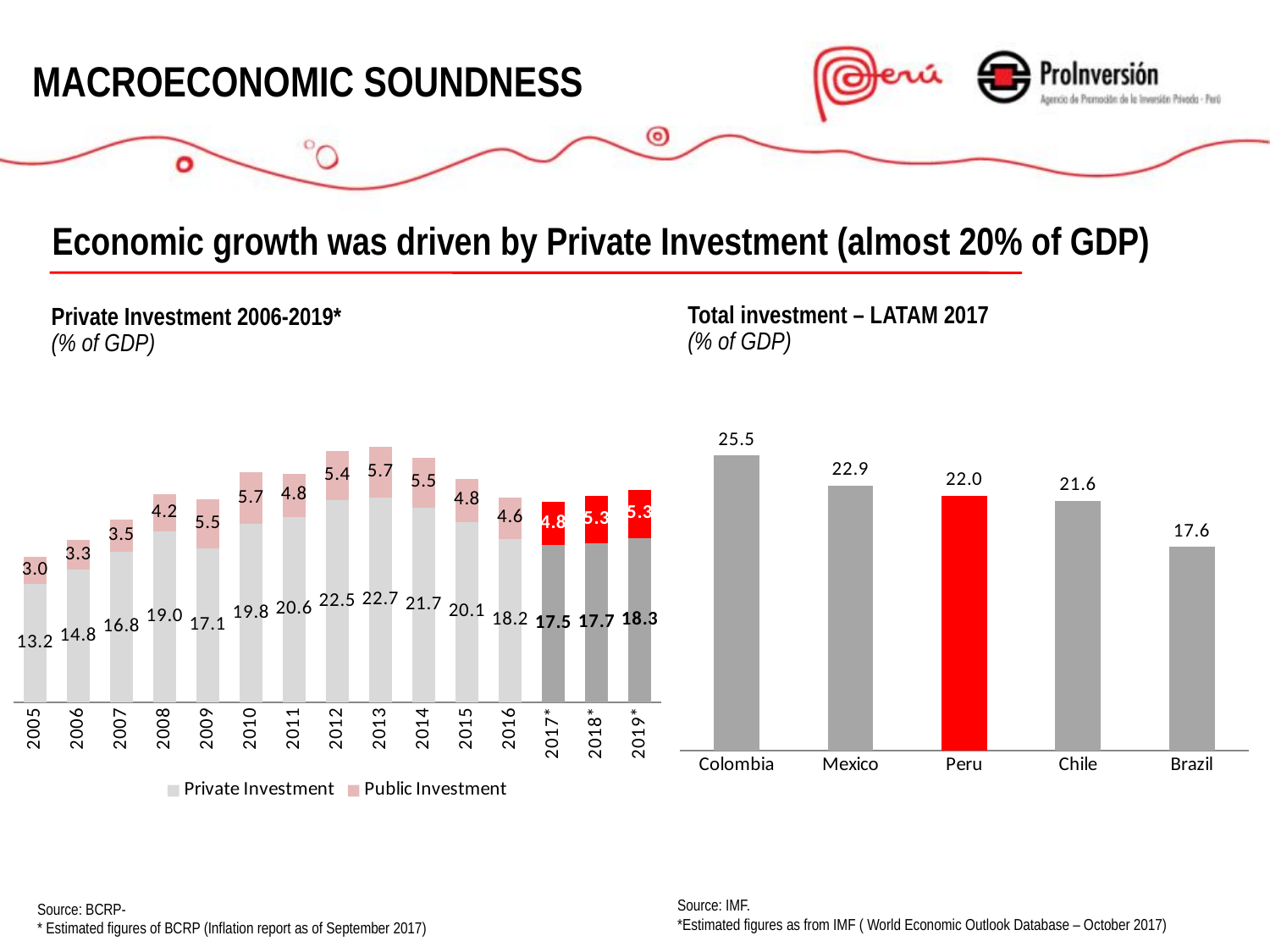
In the 'Total investment – LATAM 2017' chart, which bar is coloured red? Peru In the 'Private Investment 2006-2019*' chart, is Private Investment in 2012 larger or smaller than in 2016? larger In the 'Private Investment 2006-2019*' chart, how many series does the legend list? 2 In the 'Private Investment 2006-2019*' chart, what is the Private Investment value for 2013? 22.7 In the 'Total investment – LATAM 2017' chart, what is the value for Peru? 22.0 In the 'Private Investment 2006-2019*' chart, what is the total of the stacked bar for 2019*? 23.6 In the 'Total investment – LATAM 2017' chart, which country has the highest total investment? Colombia In the 'Total investment – LATAM 2017' chart, how many countries are shown? 5 In the 'Total investment – LATAM 2017' chart, which country has the lowest total investment? Brazil In the 'Private Investment 2006-2019*' chart, which year has the highest Private Investment? 2013 In the 'Private Investment 2006-2019*' chart, what is the Public Investment value for 2009? 5.5 In the 'Total investment – LATAM 2017' chart, what is the difference between Colombia and Brazil? 7.9